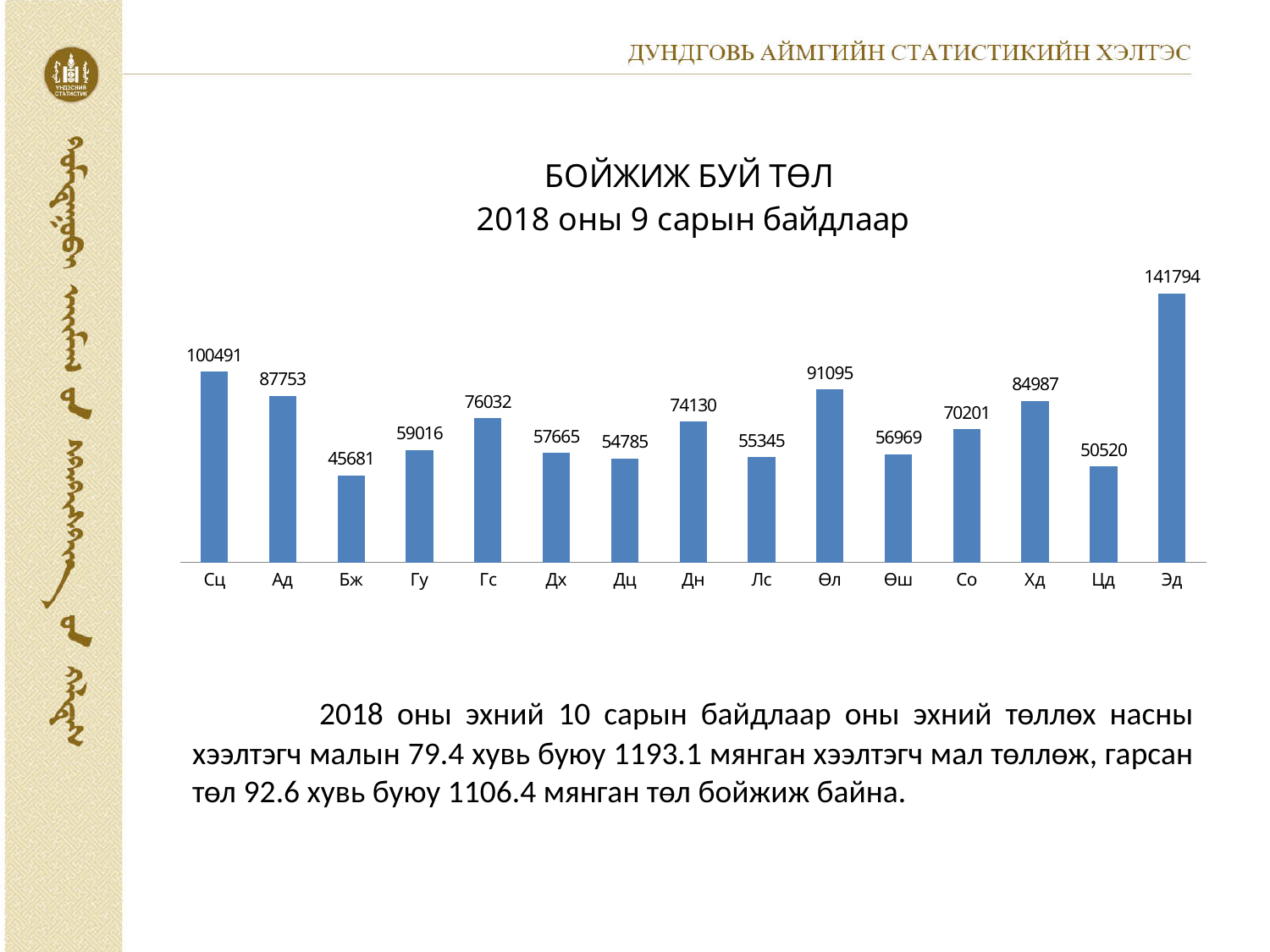
How many categories are shown on the x axis? 15 What is the difference between the values for Эд and Сц? 41303 What is the value for Өл? 91095 Which is larger, the value for Со or the value for Өш? Со Which category has the lowest value? Бж What kind of chart is shown on the slide? bar chart What is the difference between the values for Ад and Хд? 2766 Which is larger, the value for Гс or the value for Дн? Гс Which category has the highest value? Эд What is the value for Сц? 100491 What is the value for Цд? 50520 What is the title of the chart? БОЙЖИЖ БУЙ ТӨЛ 2018 оны 9 сарын байдлаар